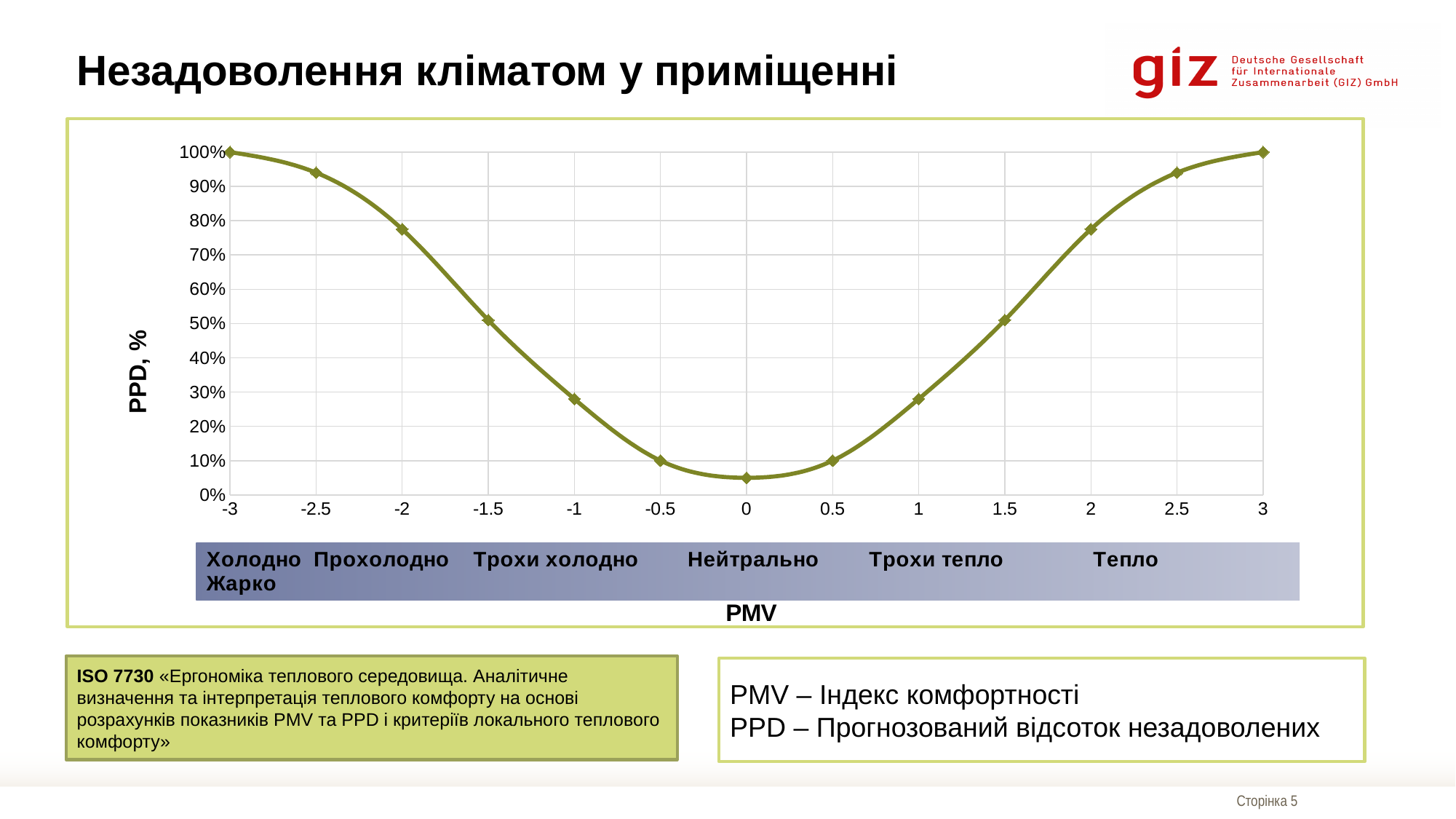
What is the PPD value at PMV = 3? 100% Is the PPD value at PMV = 1.5 greater or less than 40%? greater What is the PPD value at PMV = -0.5? 10% What is the PPD value at PMV = -3? 100% What is the label of the vertical axis? PPD, % Does PPD rise or fall as PMV goes from 0 to 3? rises At which PMV value is PPD lowest? 0 Is the PPD value at PMV = -2 greater or less than 70%? greater How many data points are plotted on the line? 13 What kind of chart is shown on the slide? line chart Which has a higher PPD value: PMV = -2 or PMV = -1? PMV = -2